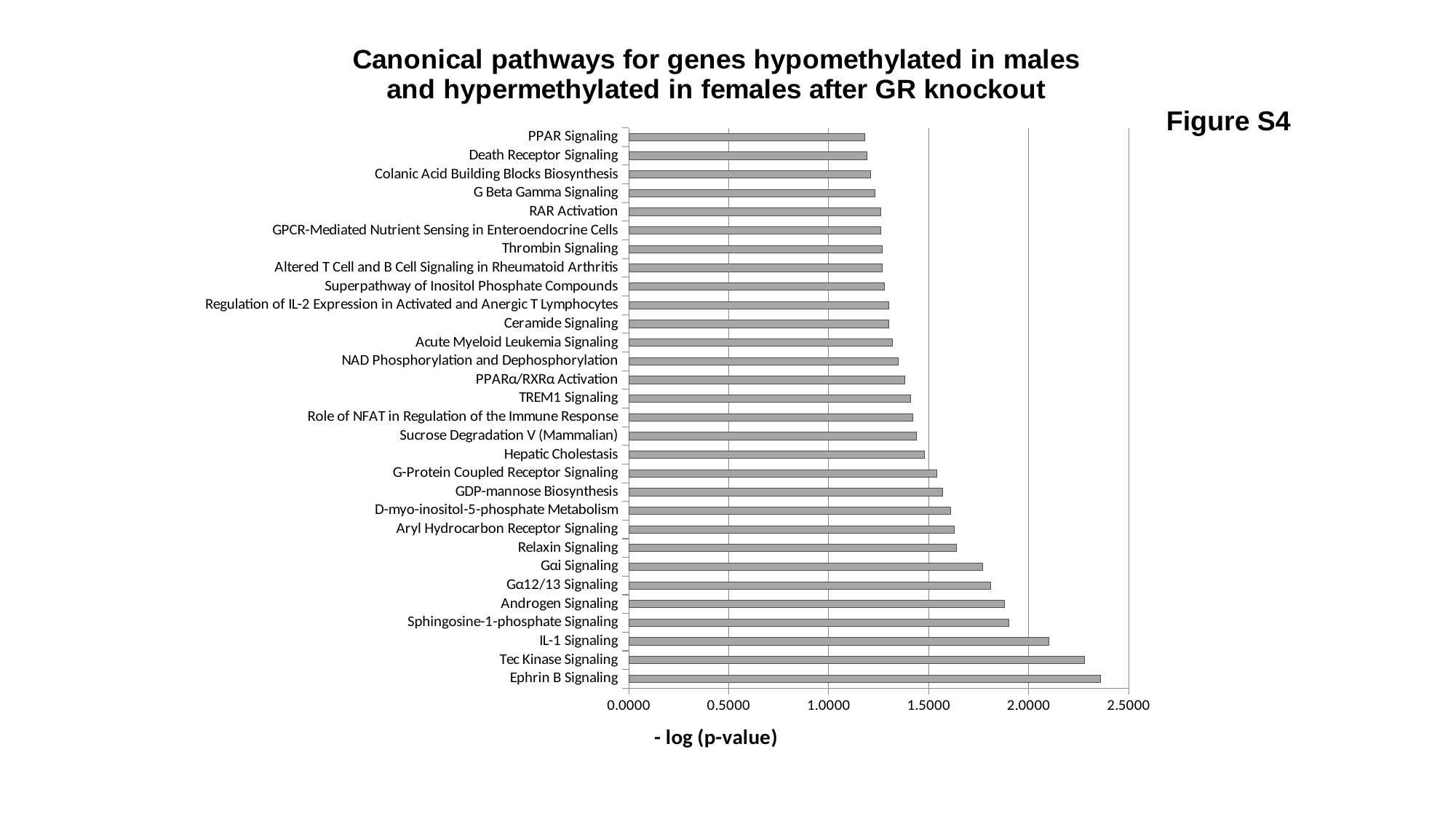
Is the value for Gαi Signaling greater or less than 1.5000? greater Is the value for Sphingosine-1-phosphate Signaling greater or less than 2.0000? less Which pathway has the highest -log(p-value) in the chart? Ephrin B Signaling Which has a larger value, Androgen Signaling or Relaxin Signaling? Androgen Signaling Is the value for PPAR Signaling greater or less than 1.5000? less Which has a larger value, Ephrin B Signaling or Tec Kinase Signaling? Ephrin B Signaling How many pathways (categories) are plotted in the chart? 30 Which pathway has the lowest -log(p-value) in the chart? PPAR Signaling What figure label appears next to the chart? Figure S4 What is the label of the horizontal (x) axis of the chart? - log (p-value) What kind of chart is shown on the slide? bar chart